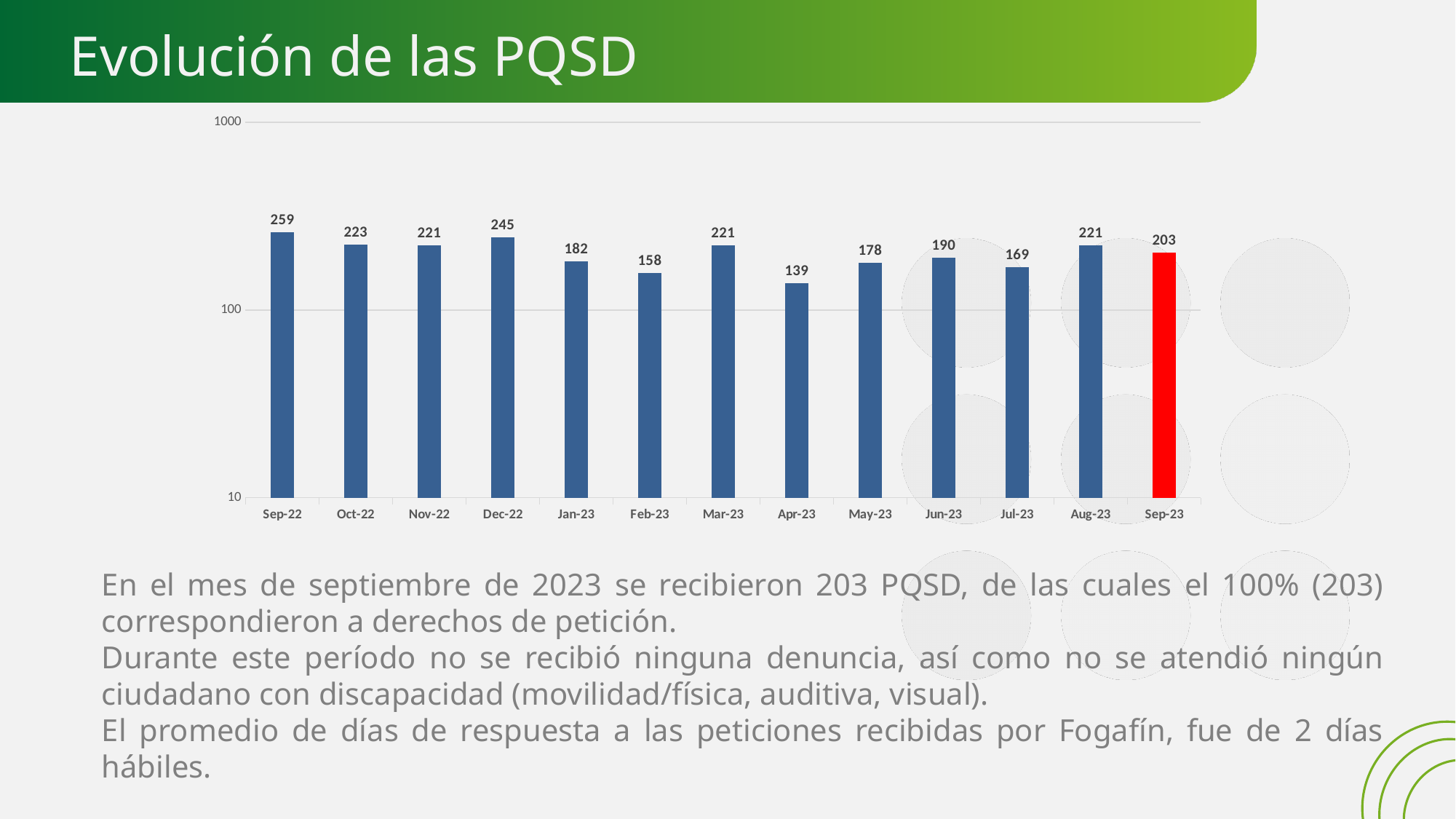
What is the value for Sep-22? 259 What is the difference between the values for Dec-22 and Jan-23? 63 What is the difference between the values for Sep-22 and Sep-23? 56 What kind of chart is shown on the slide? bar chart How many months are shown on the x axis? 13 Which month has the highest value? Sep-22 What is the value for Apr-23? 139 Which bar is coloured red instead of blue? Sep-23 Which is larger, the value for Jun-23 or the value for Jul-23? Jun-23 Which month has the lowest value? Apr-23 Is the value for Feb-23 greater or less than 100? greater What is the value for Sep-23? 203